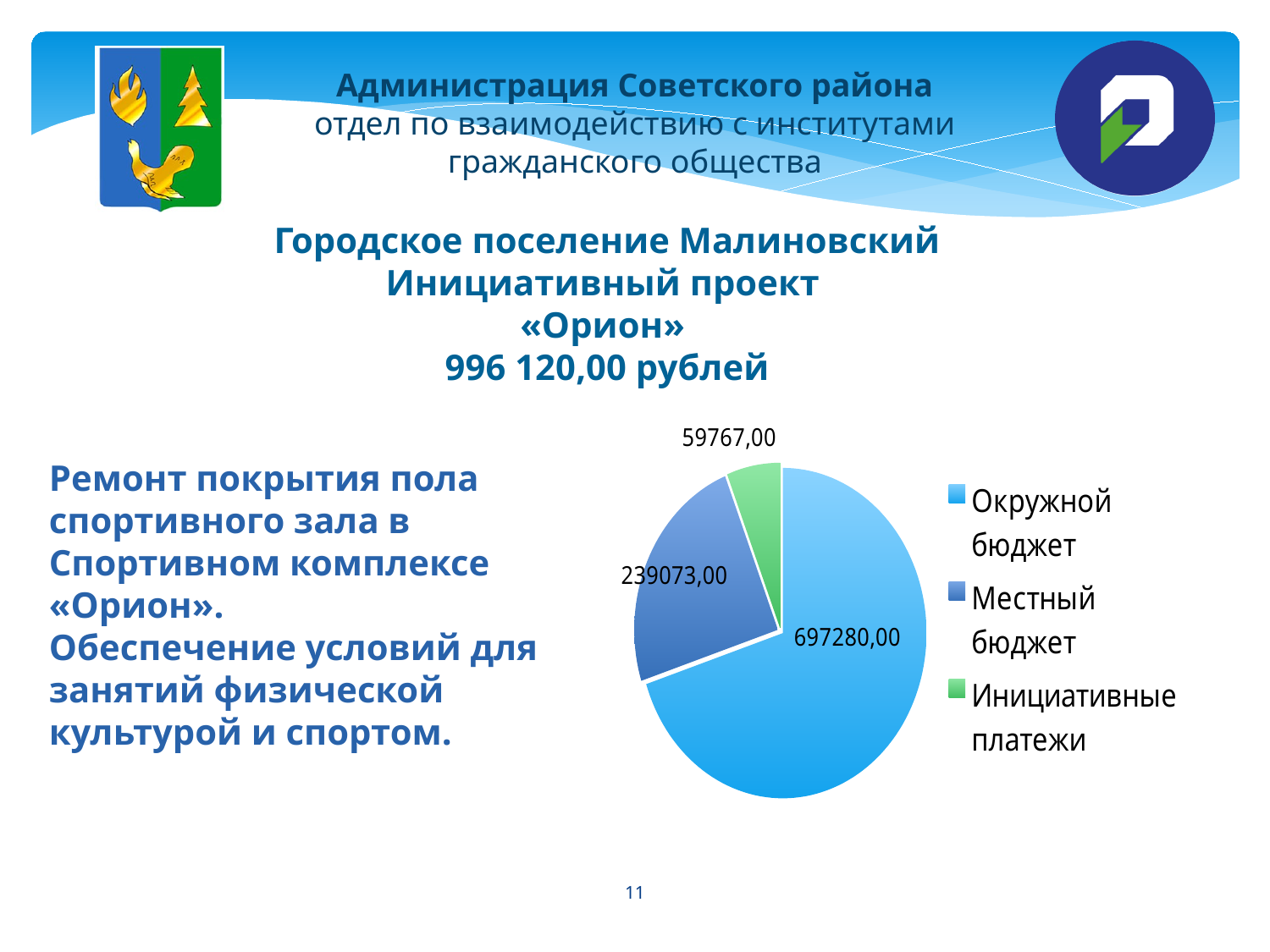
Which is larger: Местный бюджет or Инициативные платежи? Местный бюджет What kind of chart is shown on the slide? Pie chart What share of the pie does Окружной бюджет represent? 70% What colour is the slice for Инициативные платежи? Green Which category has the smallest slice in the pie chart? Инициативные платежи How many slices does the pie chart have? 3 What is the value for Окружной бюджет in the pie chart? 697280,00 What is the value for Инициативные платежи in the pie chart? 59767,00 What is the value for Местный бюджет in the pie chart? 239073,00 What is the difference between the values for Местный бюджет and Инициативные платежи? 179306,00 Which category has the largest slice in the pie chart? Окружной бюджет What is the difference between the values for Окружной бюджет and Местный бюджет? 458207,00